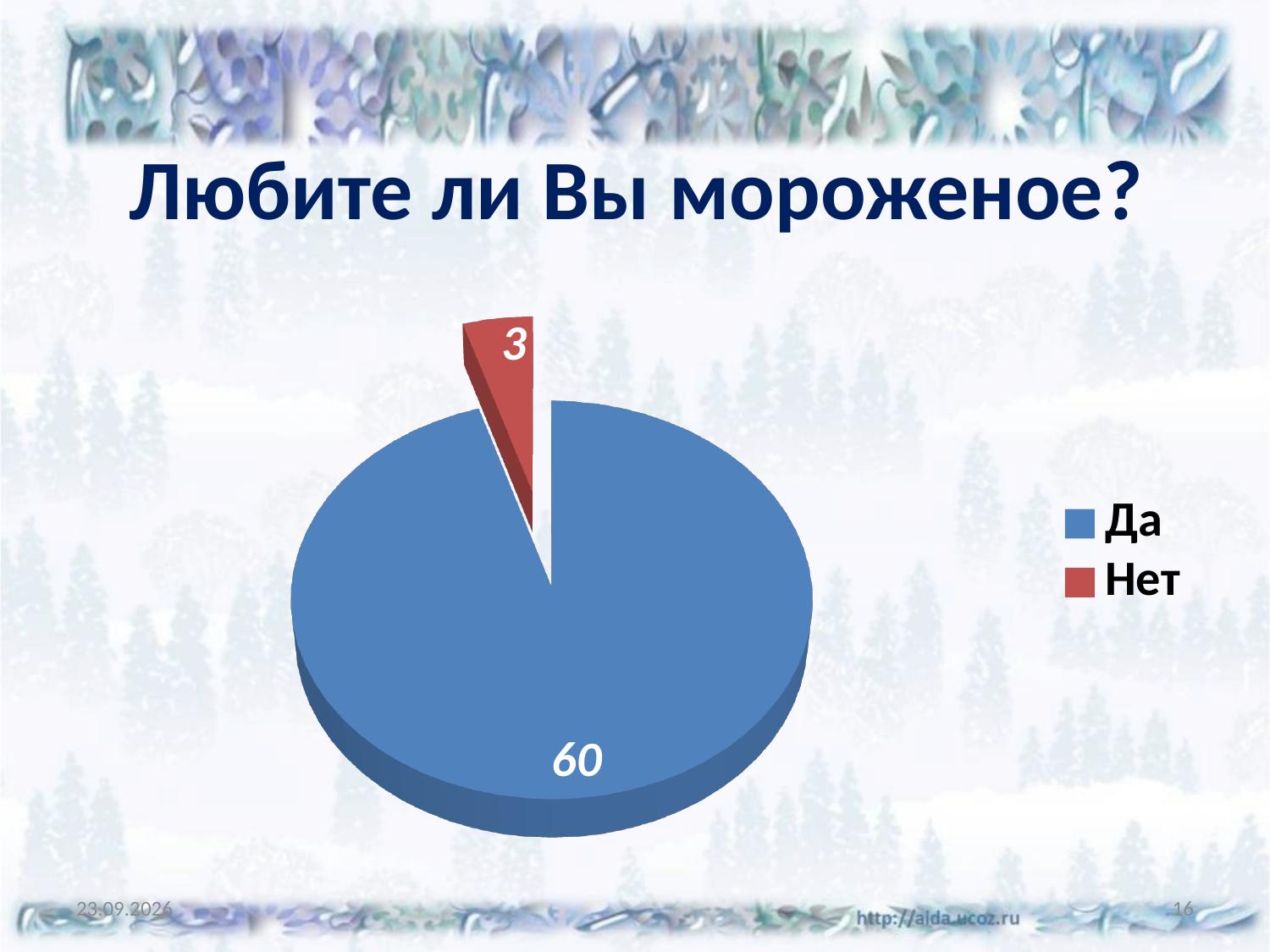
Which category has the smallest slice? Нет What is the title of the slide above the chart? Любите ли Вы мороженое? What is the difference between the values for Да and Нет? 57 What kind of chart is shown on the slide? pie chart Which category has the largest slice? Да What colour is the slice for Нет? red What is the value for Нет? 3 How many slices does the pie chart have? 2 What is the value for Да? 60 Which is larger, the value for Да or the value for Нет? Да How many entries does the legend list? 2 What is the total of all slices in the pie chart? 63